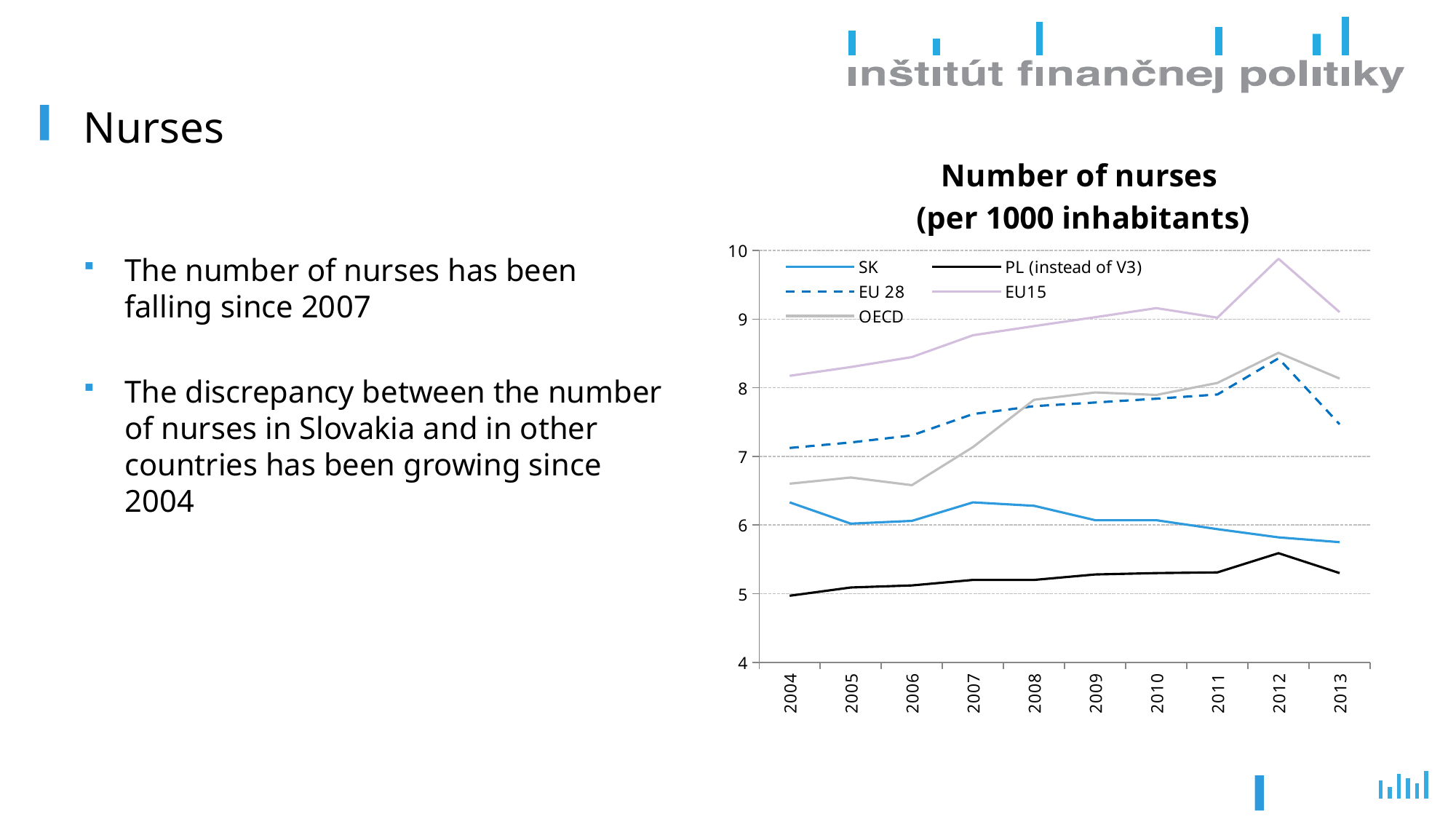
Is the value for EU 28 in 2013 greater or less than 8? less Is the value for SK in 2013 greater or less than 6? less Which series has the lowest value in 2004? PL (instead of V3) Is the value for EU15 in 2012 greater or less than 9? greater What is the title of the chart? Number of nurses (per 1000 inhabitants) Which series has the highest value in 2012? EU15 What kind of chart is shown on the slide? line chart In 2013, which is larger: the value for SK or the value for OECD? OECD Does the SK line rise or fall between 2007 and 2013? fall How many series does the legend of the chart list? 5 How many years are shown on the x axis of the chart? 10